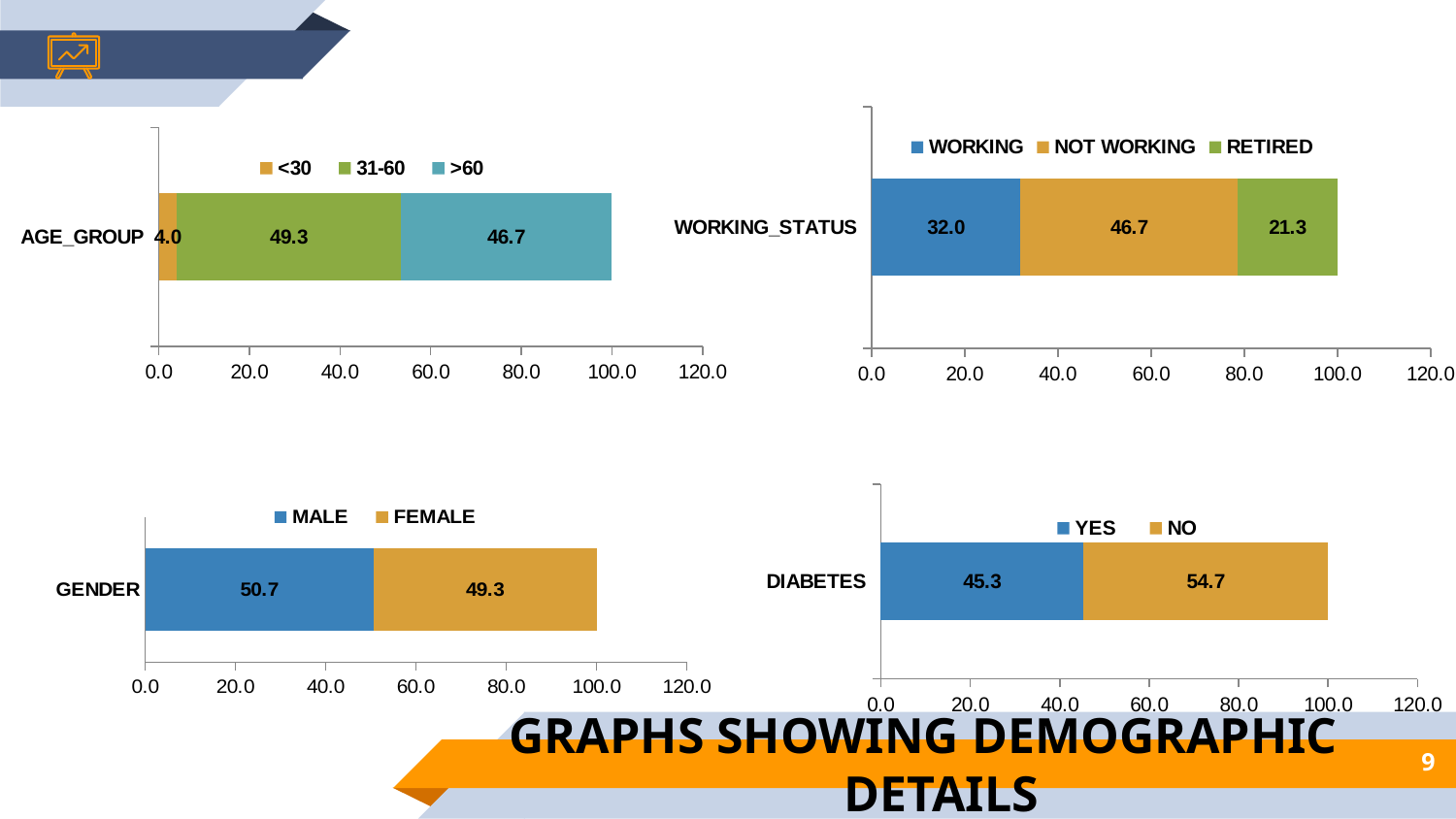
How many charts are shown on the slide? 4 In the AGE_GROUP chart (top left), which series has the lowest value? <30 In the GENDER chart (bottom left), what is the total of the stacked bar? 100.0 What kind of chart is the DIABETES chart (bottom right)? Stacked bar chart In the WORKING_STATUS chart (top right), how many series does the legend list? 3 In the WORKING_STATUS chart (top right), what is the value for RETIRED? 21.3 In the WORKING_STATUS chart (top right), which series has the highest value? NOT WORKING In the DIABETES chart (bottom right), what is the difference between the NO and YES values? 9.4 In the DIABETES chart (bottom right), which is larger, YES or NO? NO In the WORKING_STATUS chart (top right), what is the difference between the WORKING and RETIRED values? 10.7 In the GENDER chart (bottom left), what is the value for FEMALE? 49.3 In the AGE_GROUP chart (top left), what is the value for the 31-60 series? 49.3